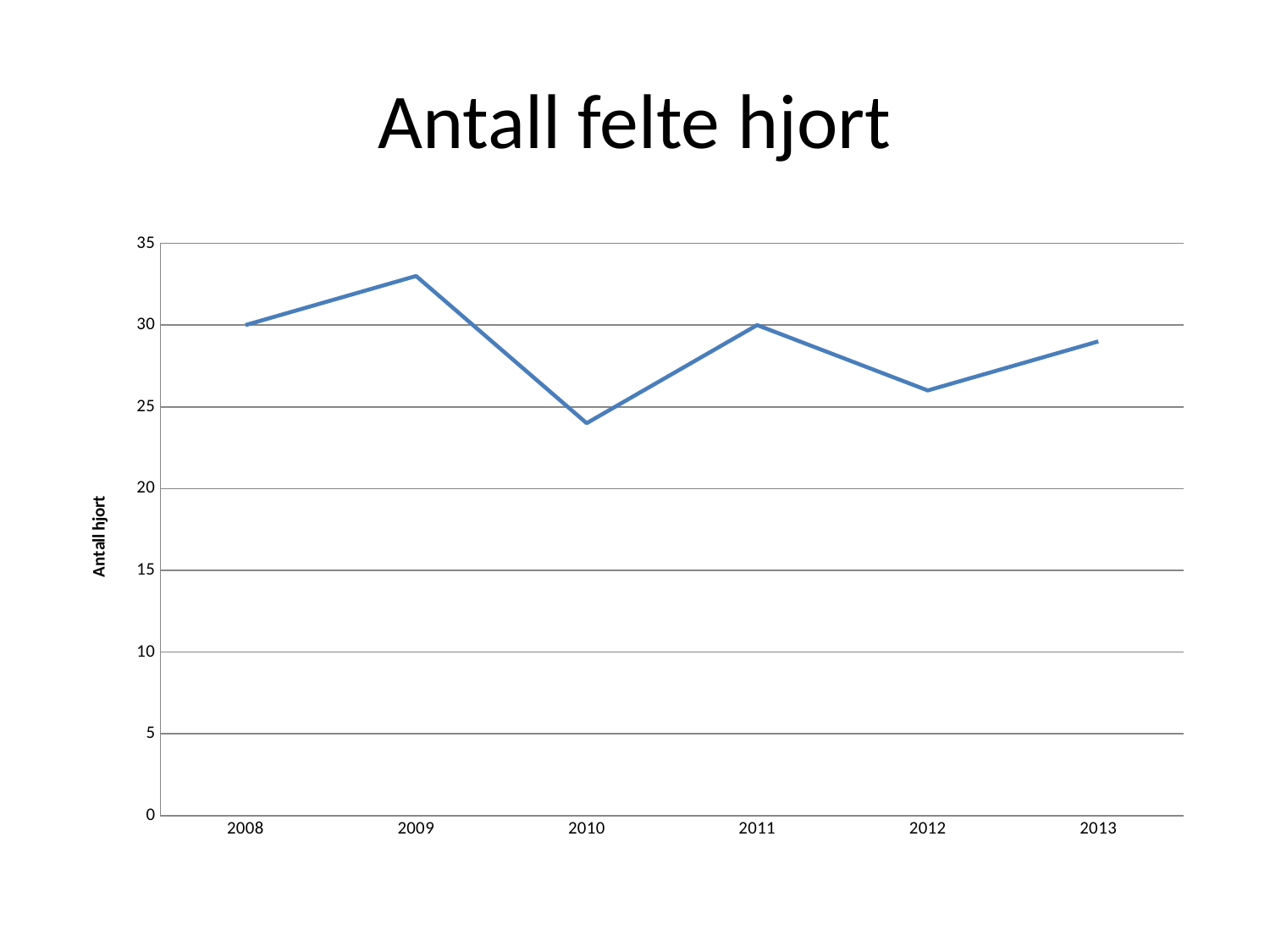
What is the label on the vertical axis? Antall hjort Does the value rise or fall from 2009 to 2010? Fall Which is larger, the value for 2012 or the value for 2013? 2013 Which year has the lowest value? 2010 How many years are plotted on the x axis? 6 Is the value for 2009 greater or less than 30? greater What is the title of the chart? Antall felte hjort Which year has the highest value? 2009 What is the value for 2008? 30 Is the value for 2010 greater or less than 25? less What type of chart is shown on the slide? Line chart What is the value for 2011? 30